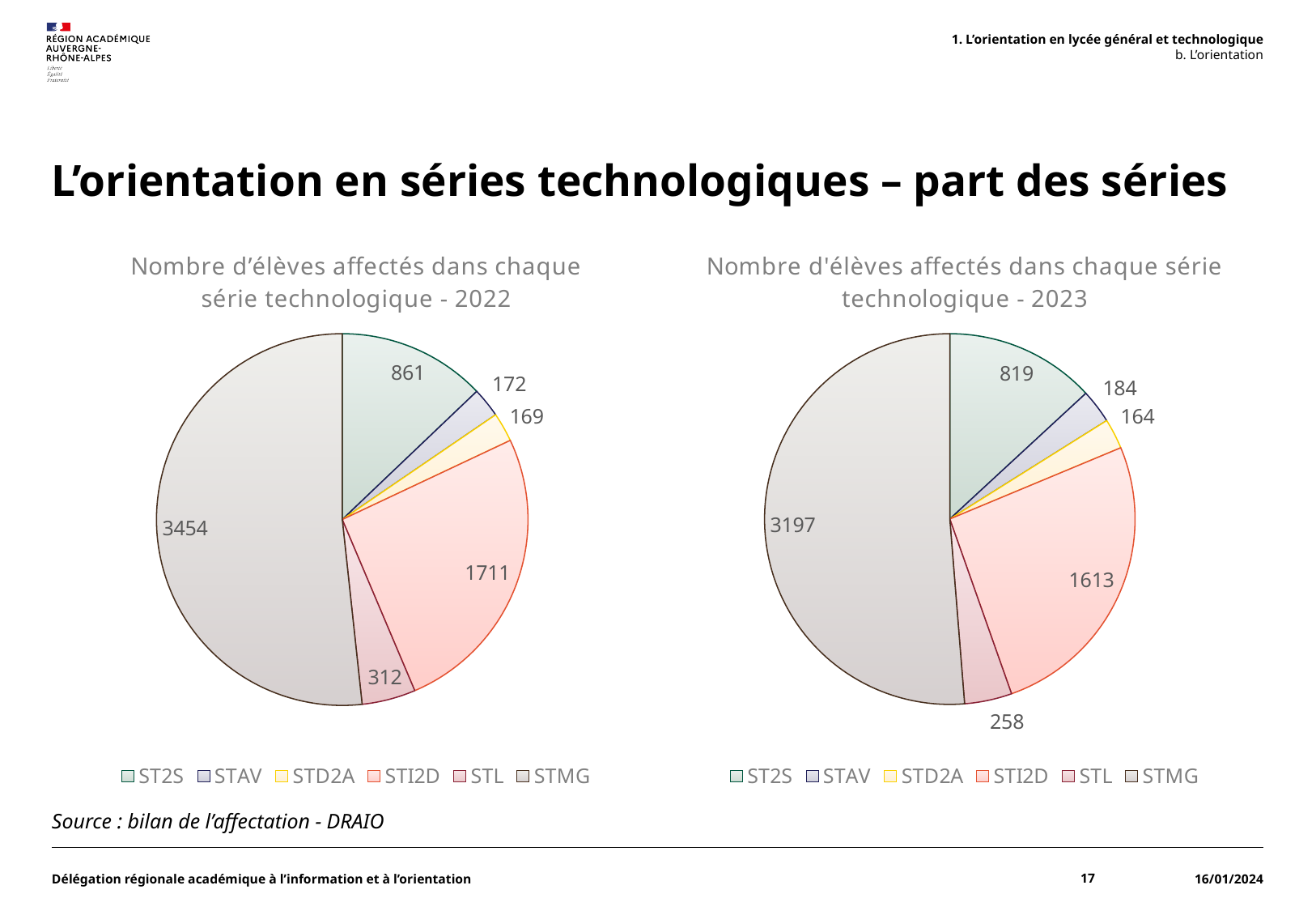
In the 2022 chart, how many students were assigned to STI2D? 1711 In the 2023 chart, how many students were assigned to STMG? 3197 What type of chart is used on this slide? Pie chart What is the difference between the STMG values in the 2022 chart and the 2023 chart? 257 In the 2022 chart, which series has the largest number of students? STMG In the 2022 chart, what is the difference between the STI2D and ST2S values? 850 In the 2023 chart, which is larger, STAV or STD2A? STAV What is the title of the chart on the left? Nombre d'élèves affectés dans chaque série technologique - 2022 What is the total number of students across all series in the 2023 chart? 6235 In the 2023 chart, what is the value for STL? 258 In the 2023 chart, which series has the smallest number of students? STD2A How many slices does the 2022 pie chart have? 6